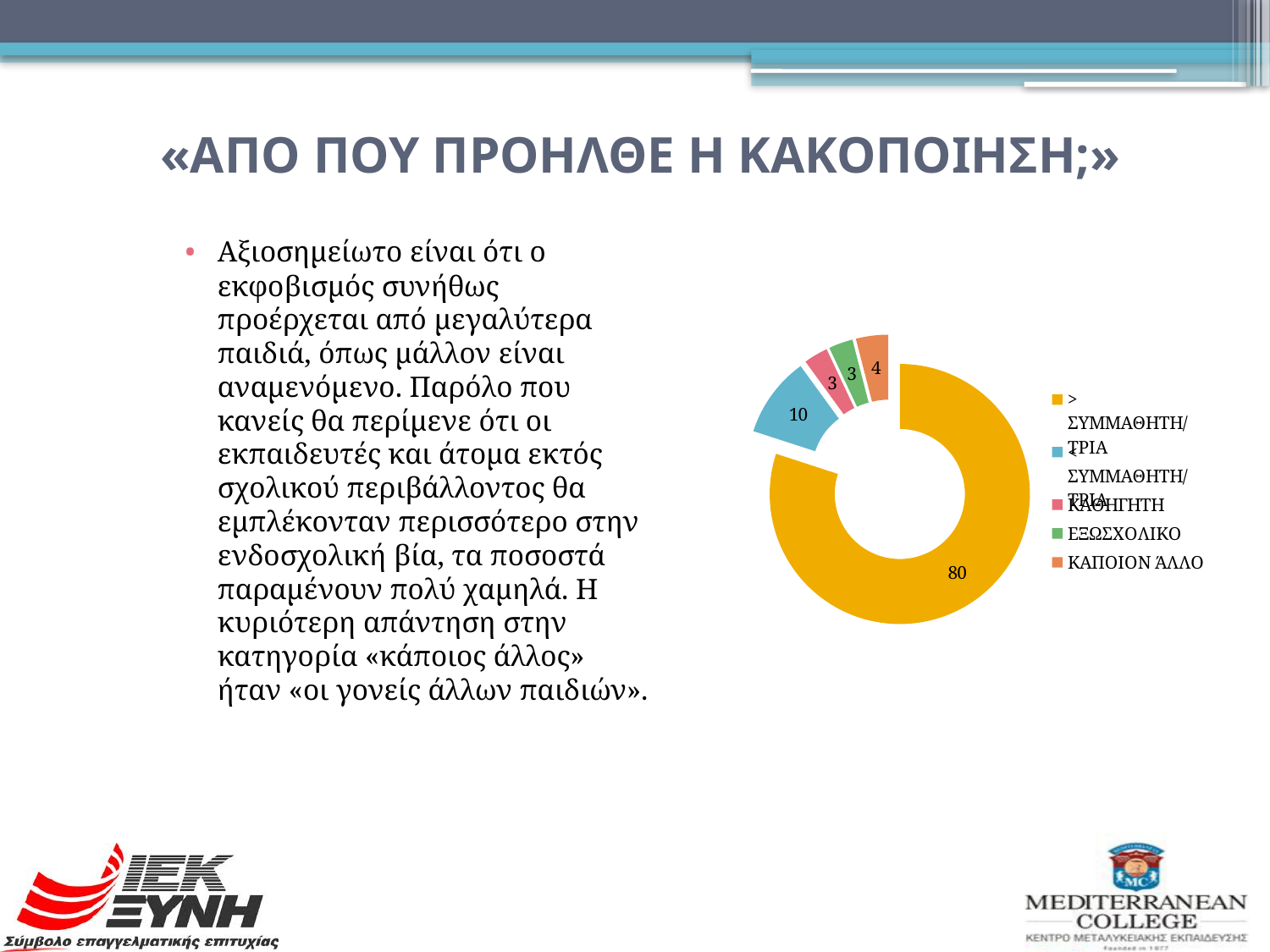
What value is shown for the ΚΑΘΗΓΗΤΗ slice? 3 What is the difference between the > ΣΥΜΜΑΘΗΤΗ/ΤΡΙΑ value and the ΣΥΜΜΑΘΗΤΗ/ΤΡΙΑ value? 70 Which is larger, the ΚΑΠΟΙΟΝ ΆΛΛΟ slice or the ΕΞΩΣΧΟΛΙΚΟ slice? ΚΑΠΟΙΟΝ ΆΛΛΟ What value is shown for the ΣΥΜΜΑΘΗΤΗ/ΤΡΙΑ slice (blue)? 10 What value is shown for the > ΣΥΜΜΑΘΗΤΗ/ΤΡΙΑ slice? 80 What colour is the ΕΞΩΣΧΟΛΙΚΟ slice in the chart? green What kind of chart is shown on the slide? doughnut chart How many categories does the chart show? 5 What value is shown for the ΚΑΠΟΙΟΝ ΆΛΛΟ slice? 4 Which category has the largest slice in the chart? > ΣΥΜΜΑΘΗΤΗ/ΤΡΙΑ What share of the total does the > ΣΥΜΜΑΘΗΤΗ/ΤΡΙΑ slice represent? 80% What is the total of all the values shown in the chart? 100